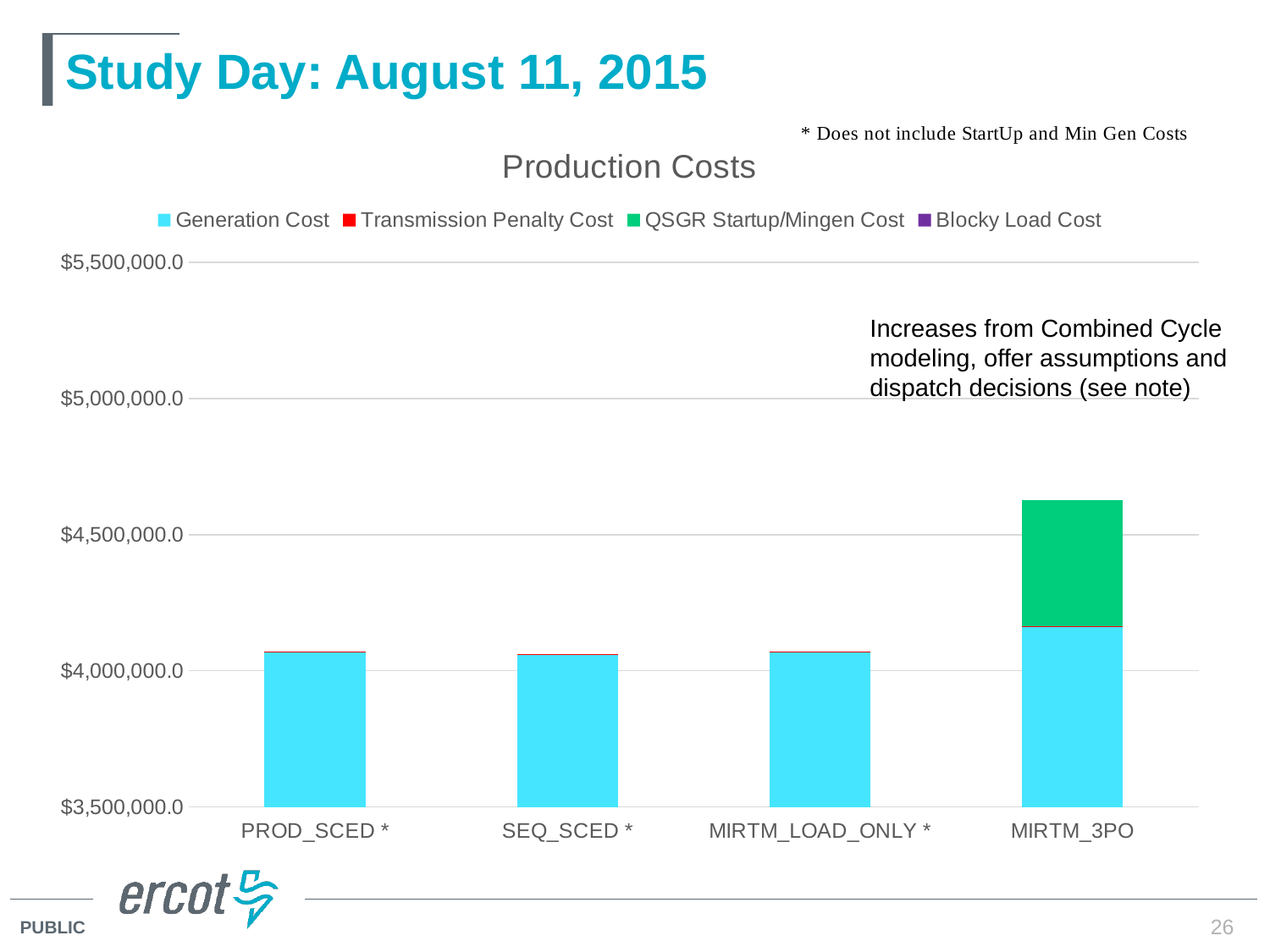
Is the value for SEQ_SCED * greater or less than $4,500,000.0? less Is the total value for MIRTM_3PO greater or less than $5,000,000.0? less Which series is shown in green in the chart's legend? QSGR Startup/Mingen Cost Which category has the highest total production cost? MIRTM_3PO Which category is the only one with a visible QSGR Startup/Mingen Cost segment? MIRTM_3PO What is the title of the chart? Production Costs Which is larger, the total for MIRTM_3PO or the total for MIRTM_LOAD_ONLY *? MIRTM_3PO How many series does the chart's legend list? 4 How many categories are shown on the x axis of the chart? 4 What kind of chart is shown on the slide? Stacked bar chart Is the total value for MIRTM_3PO greater or less than $4,500,000.0? greater